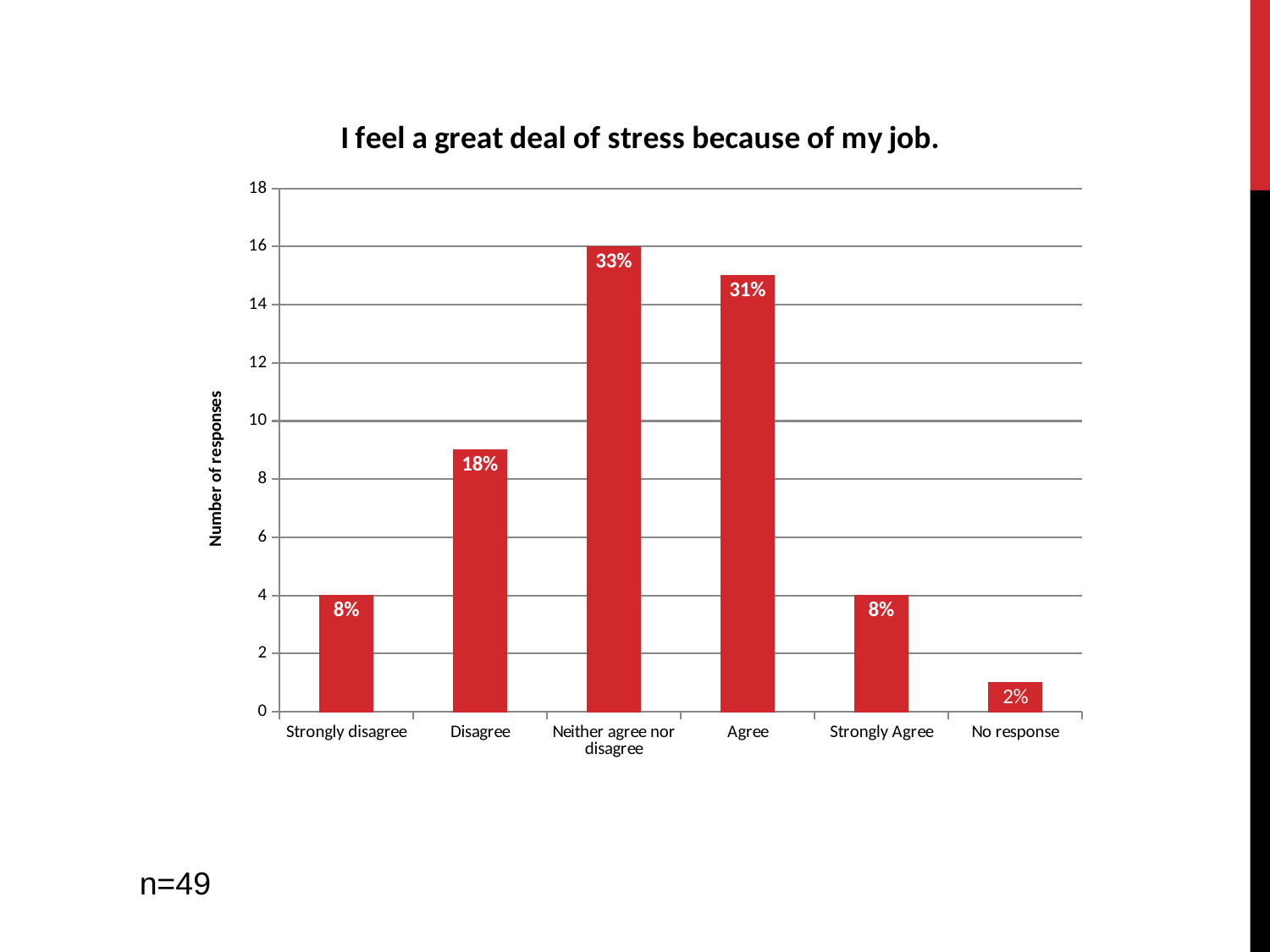
What percentage label is shown for the Agree bar? 31% What is the difference in percentage points between the Neither agree nor disagree and Agree labels? 2 percentage points What percentage label is shown for the Neither agree nor disagree bar? 33% What kind of chart is shown on the slide? Bar chart What percentage label is shown for the Disagree bar? 18% What is the title of the y axis? Number of responses Which category has the highest number of responses? Neither agree nor disagree Which category has the lowest number of responses? No response What percentage label is shown for the No response bar? 2% Is the number of responses for Disagree greater or less than 8? greater Which has a larger percentage label, Disagree or Strongly Agree? Disagree How many response categories are shown on the x axis? 6